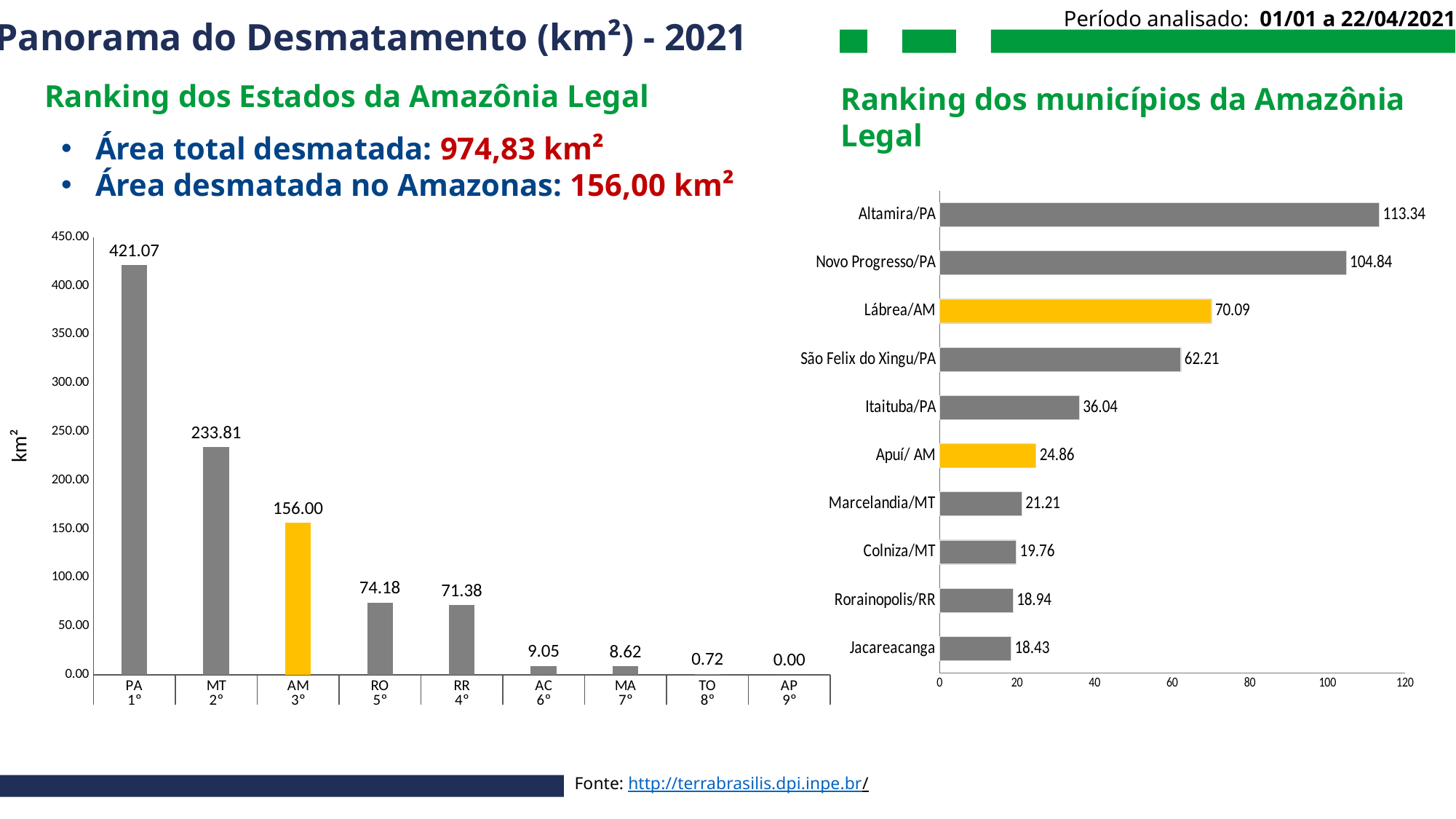
In the 'Ranking dos Estados da Amazônia Legal' chart, which state has the lowest value? AP What type of chart is the 'Ranking dos municípios da Amazônia Legal' chart? Bar chart In the 'Ranking dos Estados da Amazônia Legal' chart, what is the value for PA? 421.07 In the 'Ranking dos Estados da Amazônia Legal' chart, which bar is highlighted in yellow? AM In the 'Ranking dos Estados da Amazônia Legal' chart, what is the value for RR? 71.38 In the 'Ranking dos Estados da Amazônia Legal' chart, what is the difference between the values for PA and MT? 187.26 In the 'Ranking dos municípios da Amazônia Legal' chart, how many municipalities are listed? 10 In the 'Ranking dos municípios da Amazônia Legal' chart, what is the difference between the values for Altamira/PA and Novo Progresso/PA? 8.50 In the 'Ranking dos municípios da Amazônia Legal' chart, what is the value for Lábrea/AM? 70.09 In the 'Ranking dos municípios da Amazônia Legal' chart, which municipality has the highest value? Altamira/PA In the 'Ranking dos Estados da Amazônia Legal' chart, how many states are shown? 9 In the 'Ranking dos municípios da Amazônia Legal' chart, which is larger, the value for Itaituba/PA or Apuí/AM? Itaituba/PA